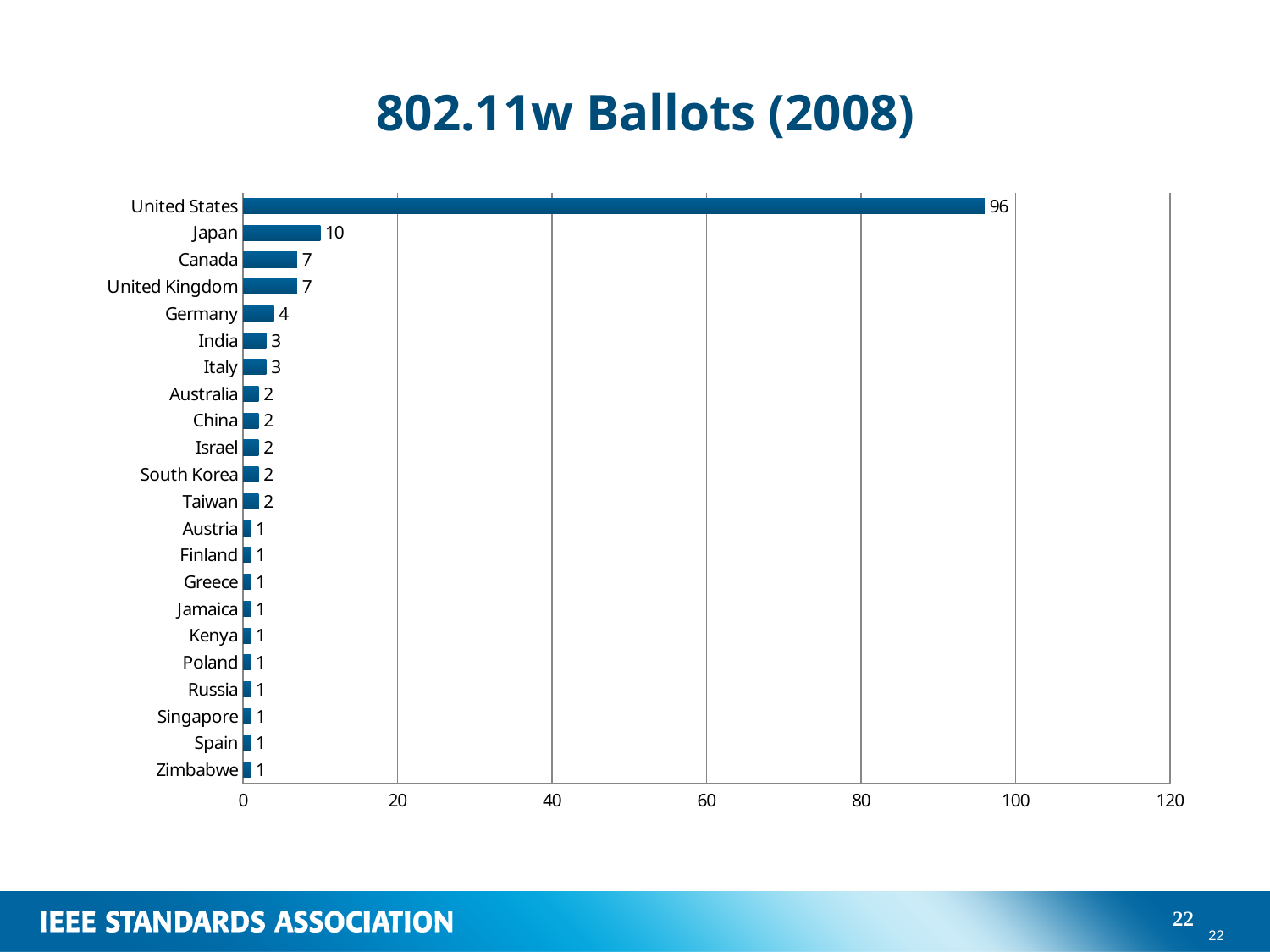
What is the difference between the values for the United States and Japan? 86 What is the value for South Korea? 2 Is the value for the United States greater or less than 80? greater What is the value for Japan? 10 What is the value for the United States? 96 What is the value for Germany? 4 What kind of chart is shown on the slide? bar chart What is the title of the chart? 802.11w Ballots (2008) What is the difference between the values for Canada and Germany? 3 How many countries are shown in the chart? 22 Which is larger, the value for Japan or the value for Canada? Japan Which country has the highest number of ballots? United States